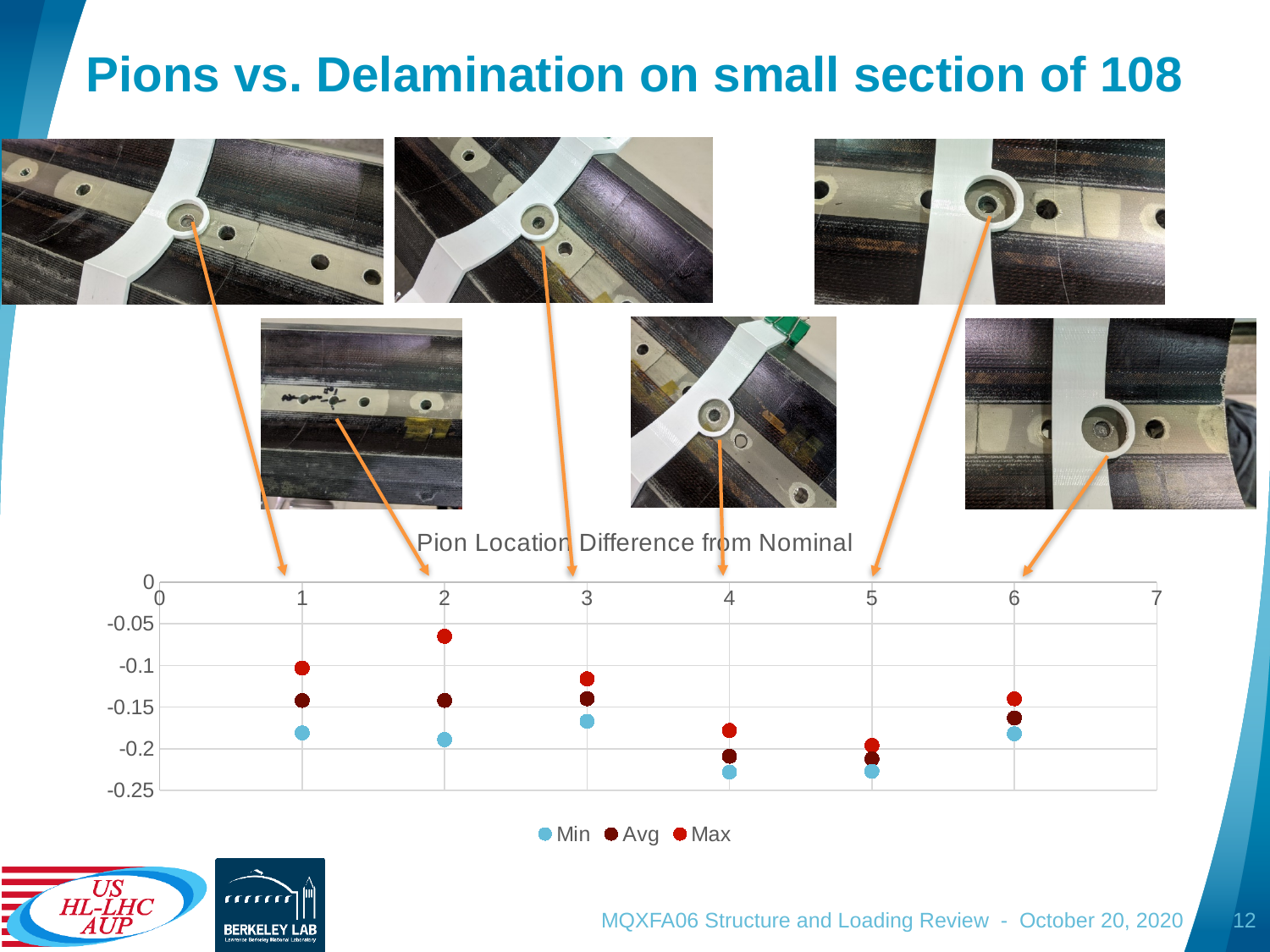
Do the Avg values rise or fall from x = 3 to x = 4? fall Is the Max value at x = 4 greater or less than -0.15? less At which x position is the Max series value highest? 2 What is the title of the chart? Pion Location Difference from Nominal Is the Min value at x = 4 greater or less than -0.2? less Is the Max value at x = 2 greater or less than -0.1? greater Which is larger, the Min value at x = 1 or the Min value at x = 4? x = 1 What are the series names listed in the chart legend? Min, Avg, Max How many series does the chart legend list? 3 What kind of chart is shown on the slide? scatter chart At how many x positions are data points plotted in the chart? 6